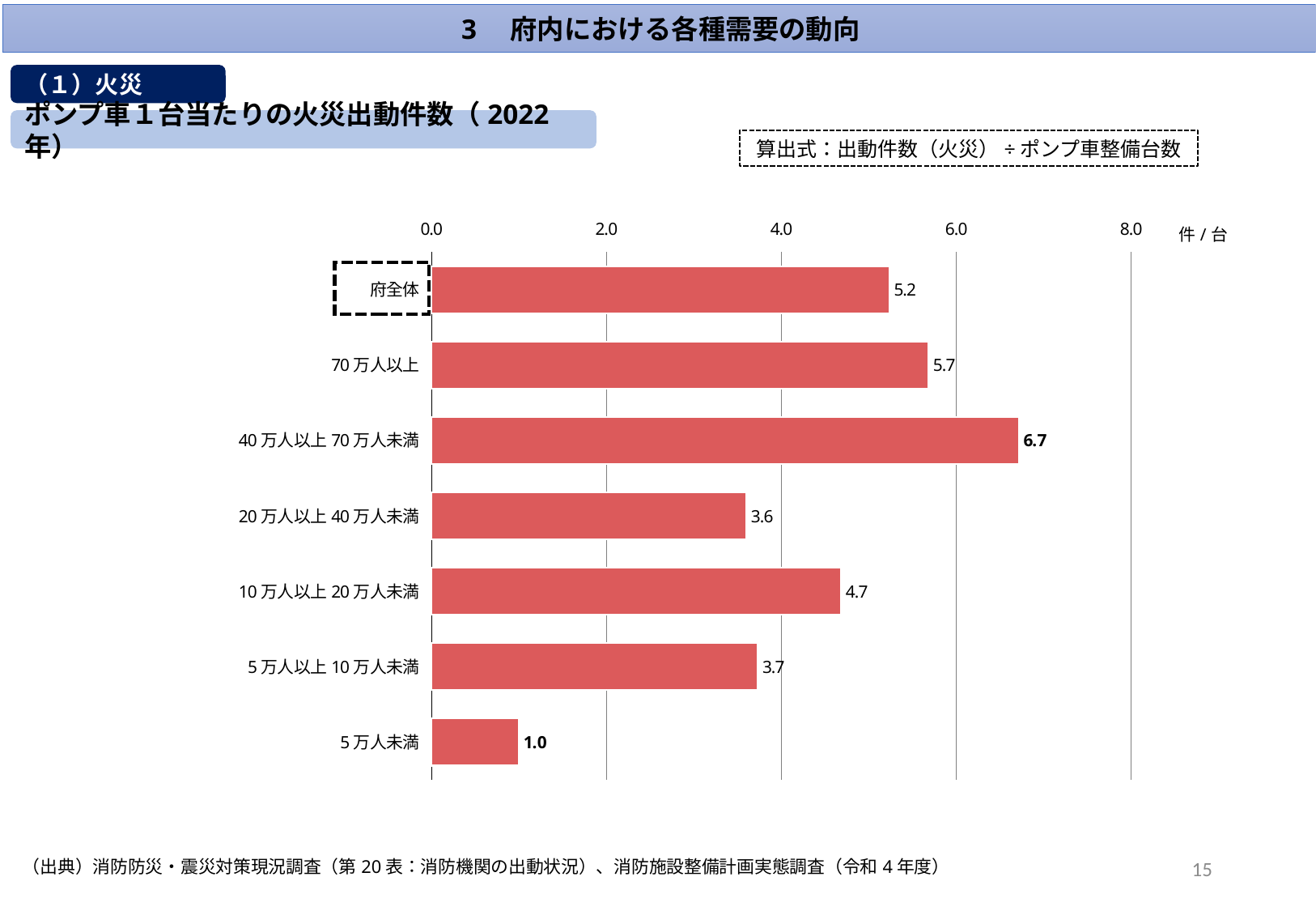
How many categories are shown in the chart? 7 What is the value for 40万人以上70万人未満? 6.7 What is the value for 府全体 (prefecture overall)? 5.2 What is the value for 5万人未満? 1.0 What is the difference between the values for 70万人以上 and 20万人以上40万人未満? 2.1 Which is larger, the value for 5万人以上10万人未満 or the value for 10万人以上20万人未満? 10万人以上20万人未満 Which category has the highest value? 40万人以上70万人未満 What is the value for 10万人以上20万人未満? 4.7 What unit is shown at the end of the horizontal axis? 件/台 Which category has the lowest value? 5万人未満 What kind of chart is shown on the slide? bar chart Is the value for 70万人以上 greater or less than 4.0? greater